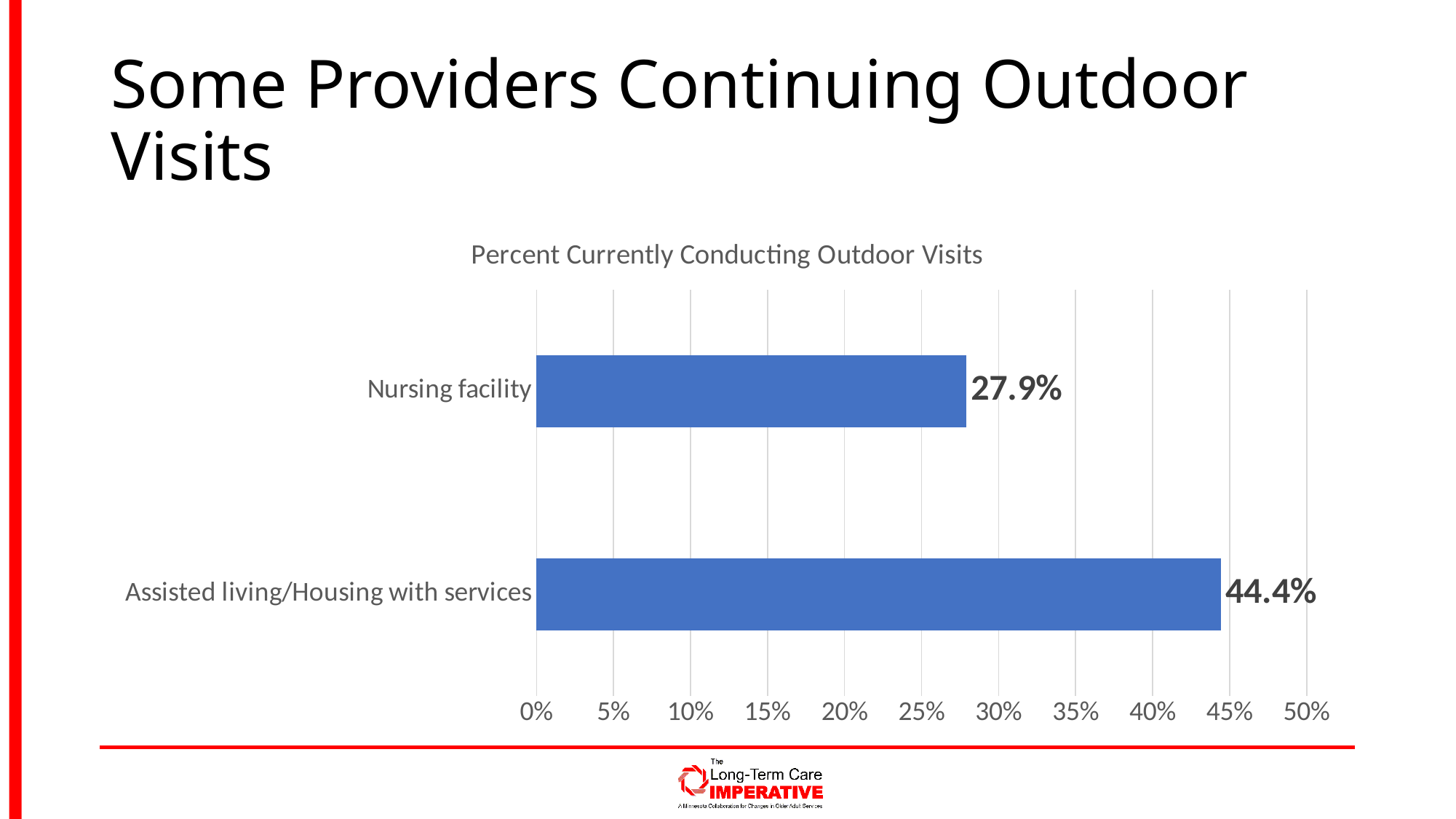
What is the value for Assisted living/Housing with services? 44.4% Is the value for Nursing facility greater or less than 30%? less What is the value for Nursing facility? 27.9% What is the maximum value shown on the horizontal axis? 50% What is the difference between the values for Assisted living/Housing with services and Nursing facility? 16.5% Which category has the lowest percent currently conducting outdoor visits? Nursing facility What is the title of the chart? Percent Currently Conducting Outdoor Visits Is the value for Assisted living/Housing with services greater or less than 40%? greater What kind of chart is shown on the slide? Bar chart Which is larger, the value for Nursing facility or the value for Assisted living/Housing with services? Assisted living/Housing with services Which category has the highest percent currently conducting outdoor visits? Assisted living/Housing with services How many categories are shown in the chart? 2